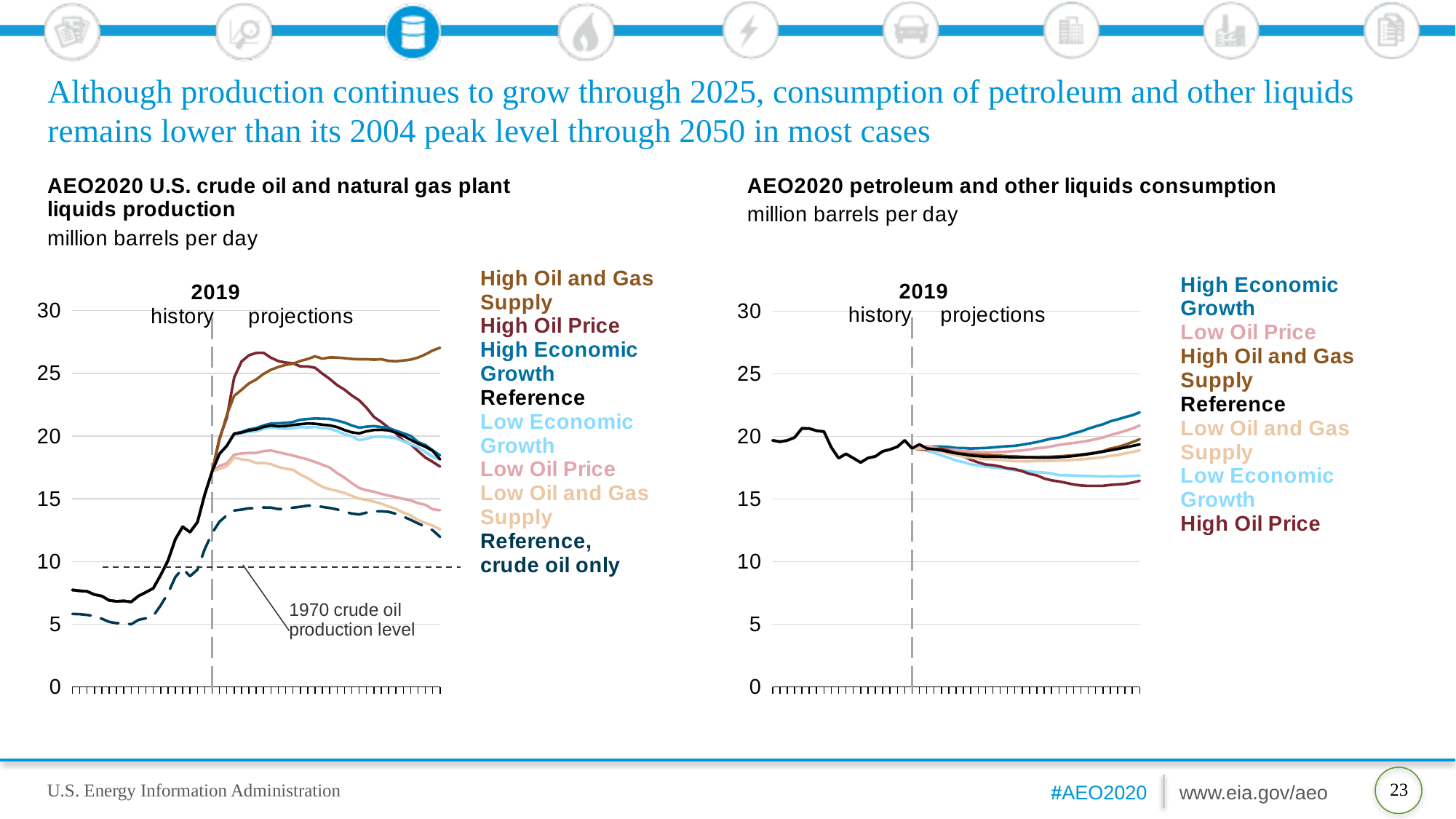
What unit is used on the vertical axis of both charts? million barrels per day What kind of chart is the AEO2020 U.S. crude oil and natural gas plant liquids production chart on the left? line chart In the left chart (production), which series is highest at the end of the projection period? High Oil and Gas Supply In the right chart (consumption), which series is highest at the end of the projection period? High Economic Growth In the left chart (production), which series is lowest at the end of the projection period? Reference, crude oil only In the left chart (production), does the Low Oil and Gas Supply series rise or fall over the projection period after its early peak? fall How many series does the legend of the right chart (petroleum and other liquids consumption) list? 7 In the left chart (production), is the value for High Oil and Gas Supply at the end of the projections greater or less than 25? greater How many series does the legend of the left chart (crude oil and natural gas plant liquids production) list? 8 In the right chart (consumption), is the value for High Oil Price at the end of the projections greater or less than 20? less In the right chart (consumption), which series is lowest at the end of the projection period? High Oil Price In the right chart (consumption), does the High Economic Growth series rise or fall over the projection period? rise